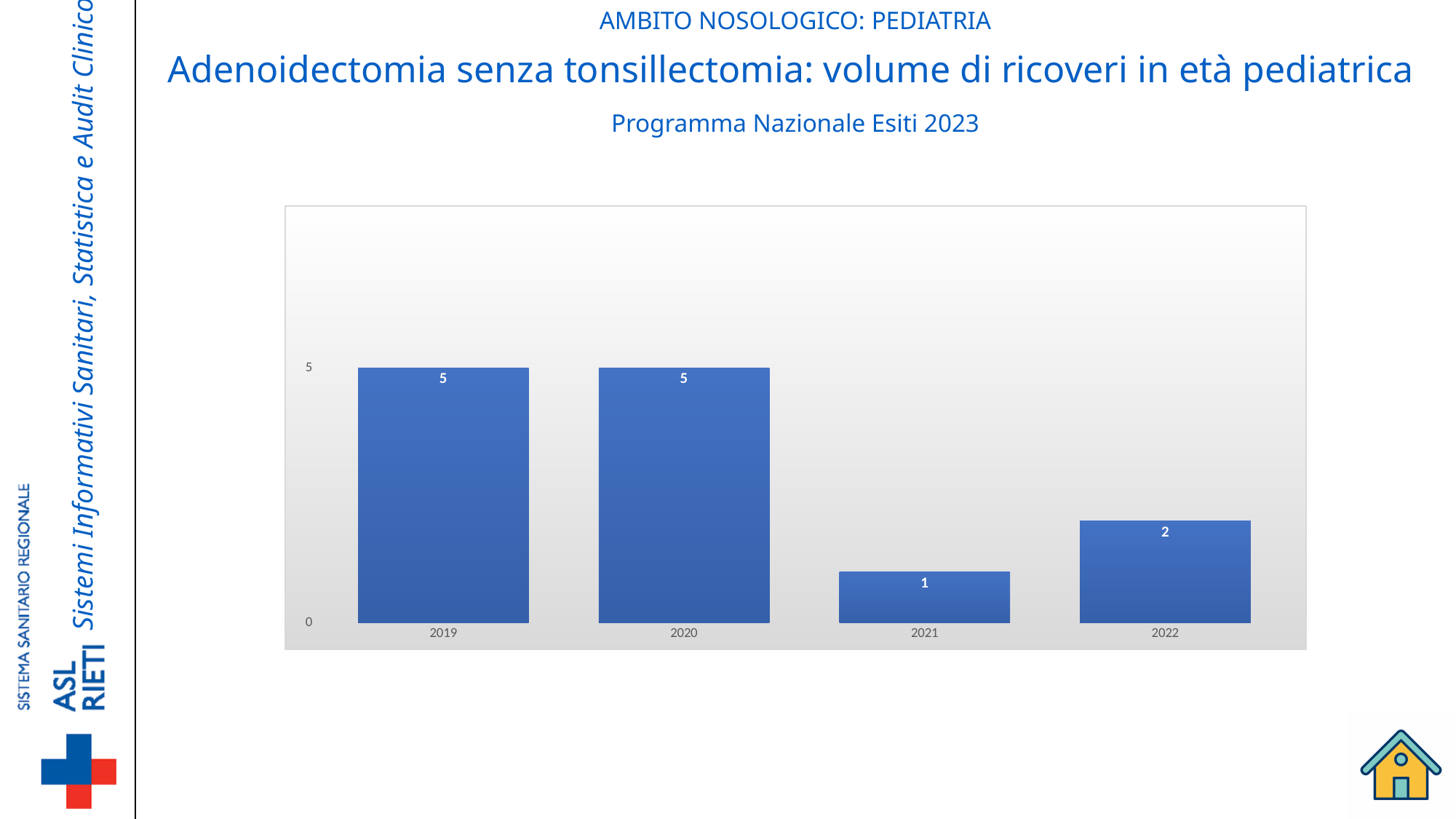
Which is larger, the value for 2019 or the value for 2022? 2019 What is the total of the values for all four years? 13 What is the value for 2022? 2 What kind of chart is shown on the slide? bar chart Do the values rise or fall from 2020 to 2021? fall What is the value for 2021? 1 Which year has the lowest value? 2021 How many years are shown on the x axis? 4 What is the value for 2019? 5 What is the difference between the values for 2022 and 2021? 1 What is the difference between the values for 2020 and 2021? 4 What is the value for 2020? 5